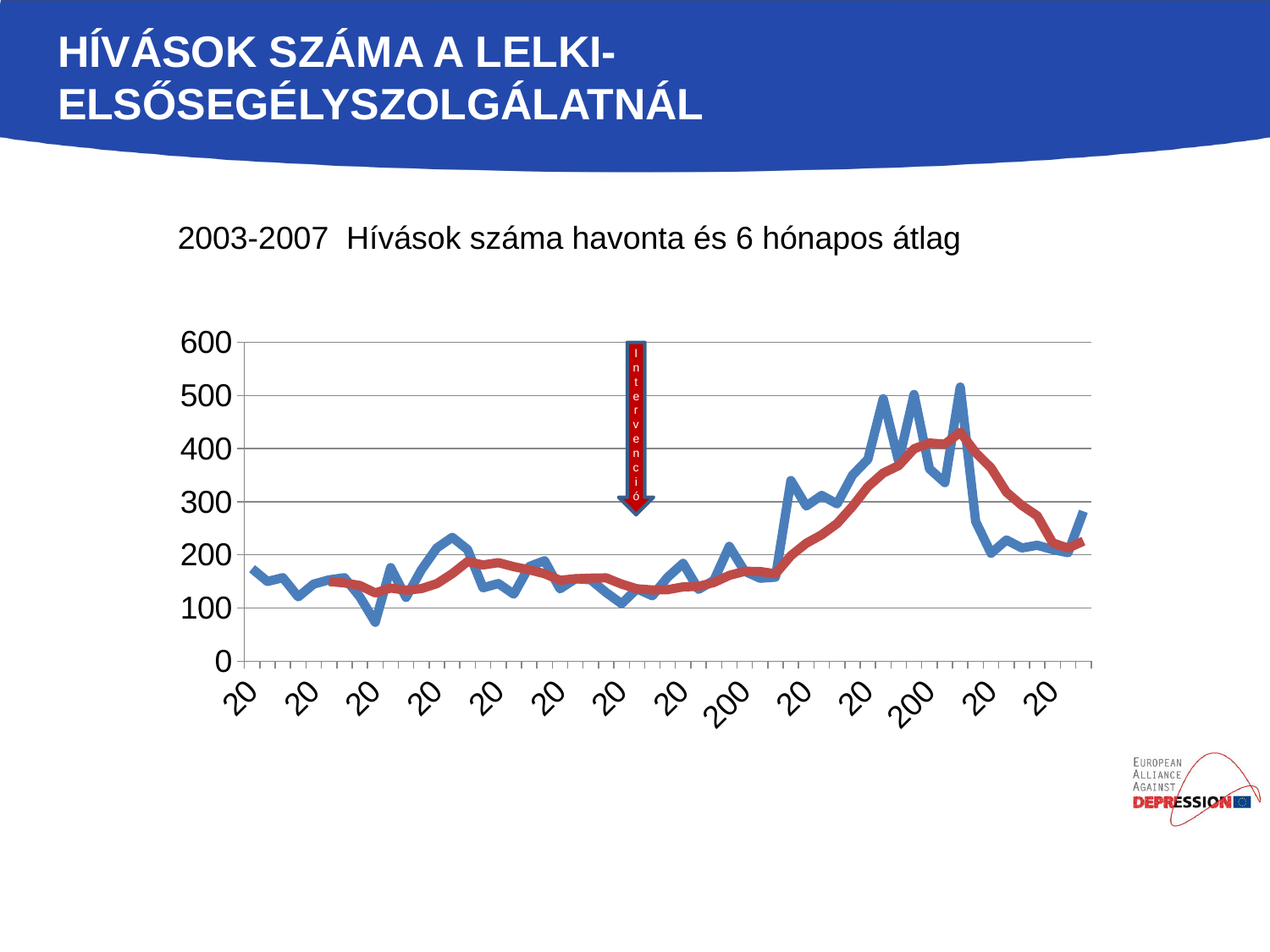
Is the lowest point of the blue line greater or less than 100? less What is the highest value shown on the vertical axis? 600 Is the lowest point of the red line greater or less than 200? less Is the first value of the blue line greater or less than 100? greater Overall, is the last value of the blue line higher or lower than its first value? higher Do the values of the red line rise or fall in the period immediately after the 'Intervenció' arrow? rise What kind of chart is shown on the slide? line chart What is the title of the chart? 2003-2007 Hívások száma havonta és 6 hónapos átlag How many lines are plotted on the chart? 2 Which line reaches a higher peak, the blue line or the red line? the blue line